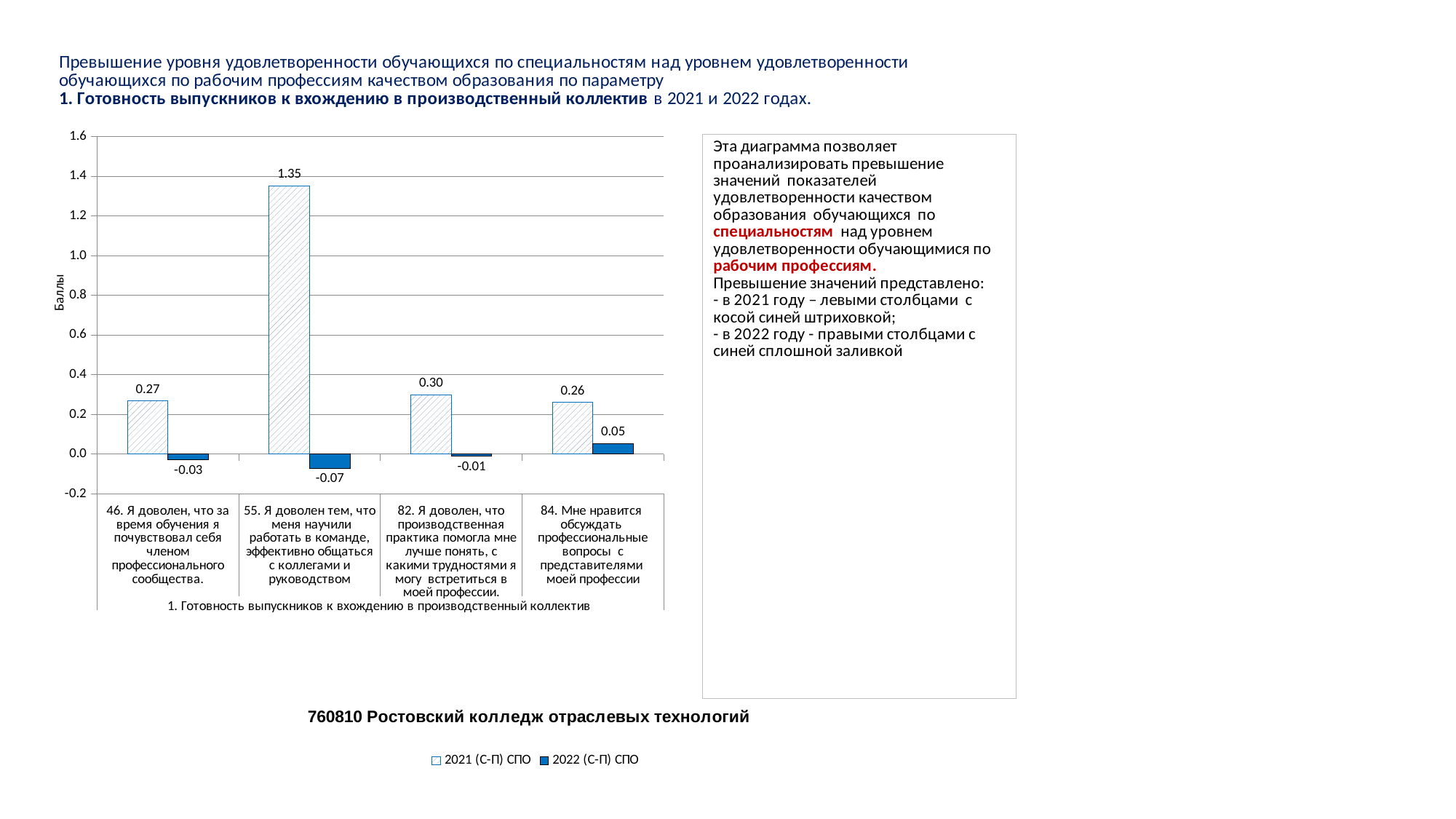
Which is larger for category 82: the 2021 (С-П) СПО value or the 2022 (С-П) СПО value? 2021 (С-П) СПО How many categories (questions) are shown on the x axis? 4 What is the label of the y axis? Баллы Which category has the lowest 2022 (С-П) СПО value? 55. Я доволен тем, что меня научили работать в команде, эффективно общаться с коллегами и руководством Which category has the highest 2021 (С-П) СПО value? 55. Я доволен тем, что меня научили работать в команде, эффективно общаться с коллегами и руководством What is the 2022 (С-П) СПО value for category 84 ("Мне нравится обсуждать профессиональные вопросы...")? 0.05 Is the 2021 (С-П) СПО value for category 55 greater or less than 1.0? greater What is the difference between the 2021 (С-П) СПО value for category 55 and the 2021 (С-П) СПО value for category 46? 1.08 What type of chart is shown on the slide? bar chart What is the 2021 (С-П) СПО value for category 55 ("Я доволен тем, что меня научили работать в команде...")? 1.35 How many series does the legend list? 2 What is the 2022 (С-П) СПО value for category 46 ("Я доволен, что за время обучения я почувствовал себя членом профессионального сообщества")? -0.03